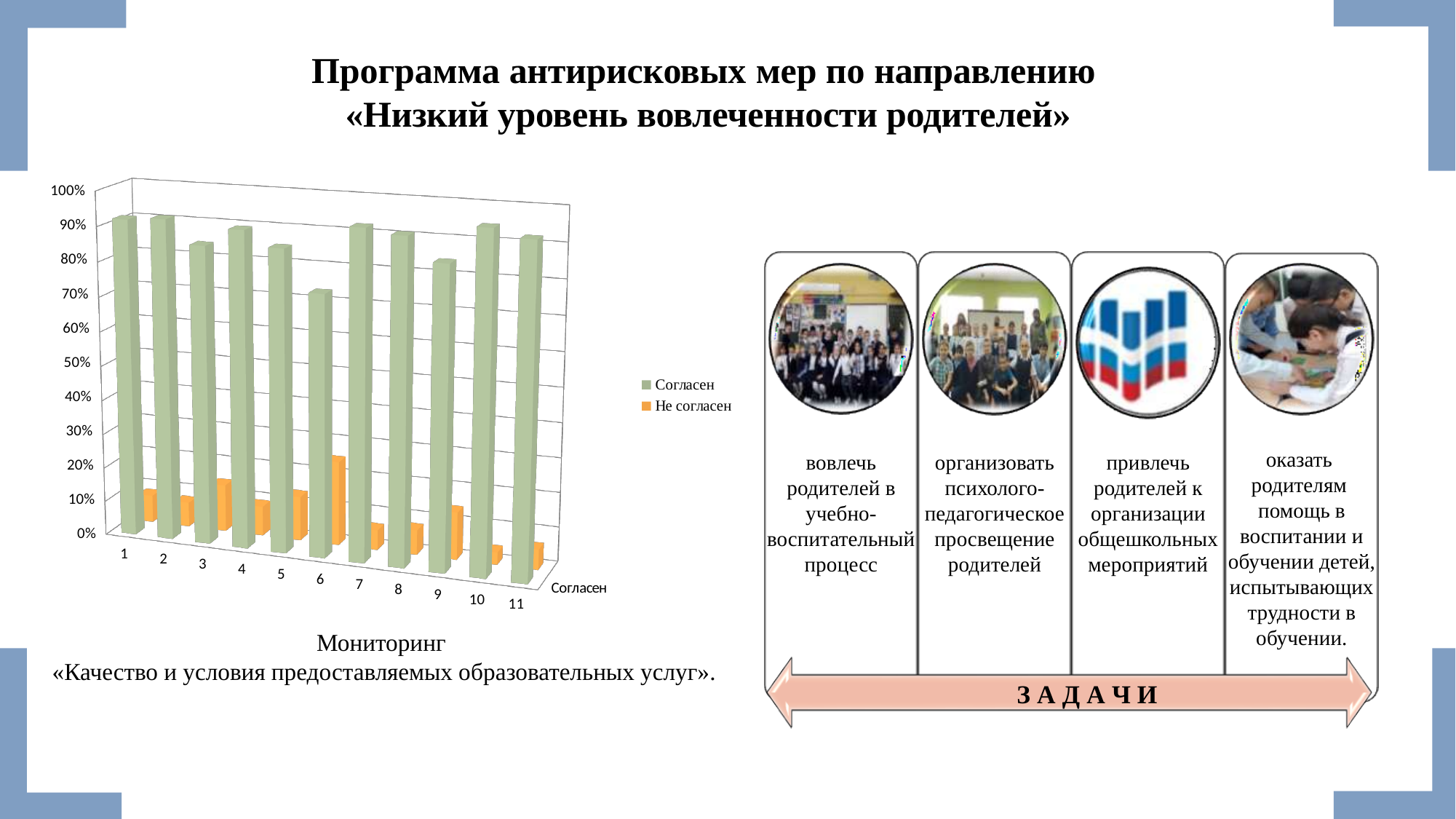
Which category has the highest value for the series Не согласен? 6 Is the value of Не согласен for category 10 greater or less than 10%? less What kind of chart is shown on the slide? bar chart Is the value of Согласен for category 6 greater or less than 80%? less Is the value of Согласен for category 1 greater or less than 80%? greater What are the two series named in the chart legend? Согласен, Не согласен How many series does the chart legend list? 2 How many categories are shown along the x axis of the chart? 11 Which colour represents the series Согласен in the chart? green Which category has the lowest value for the series Согласен? 6 Which category has the larger value for Согласен, category 1 or category 6? 1